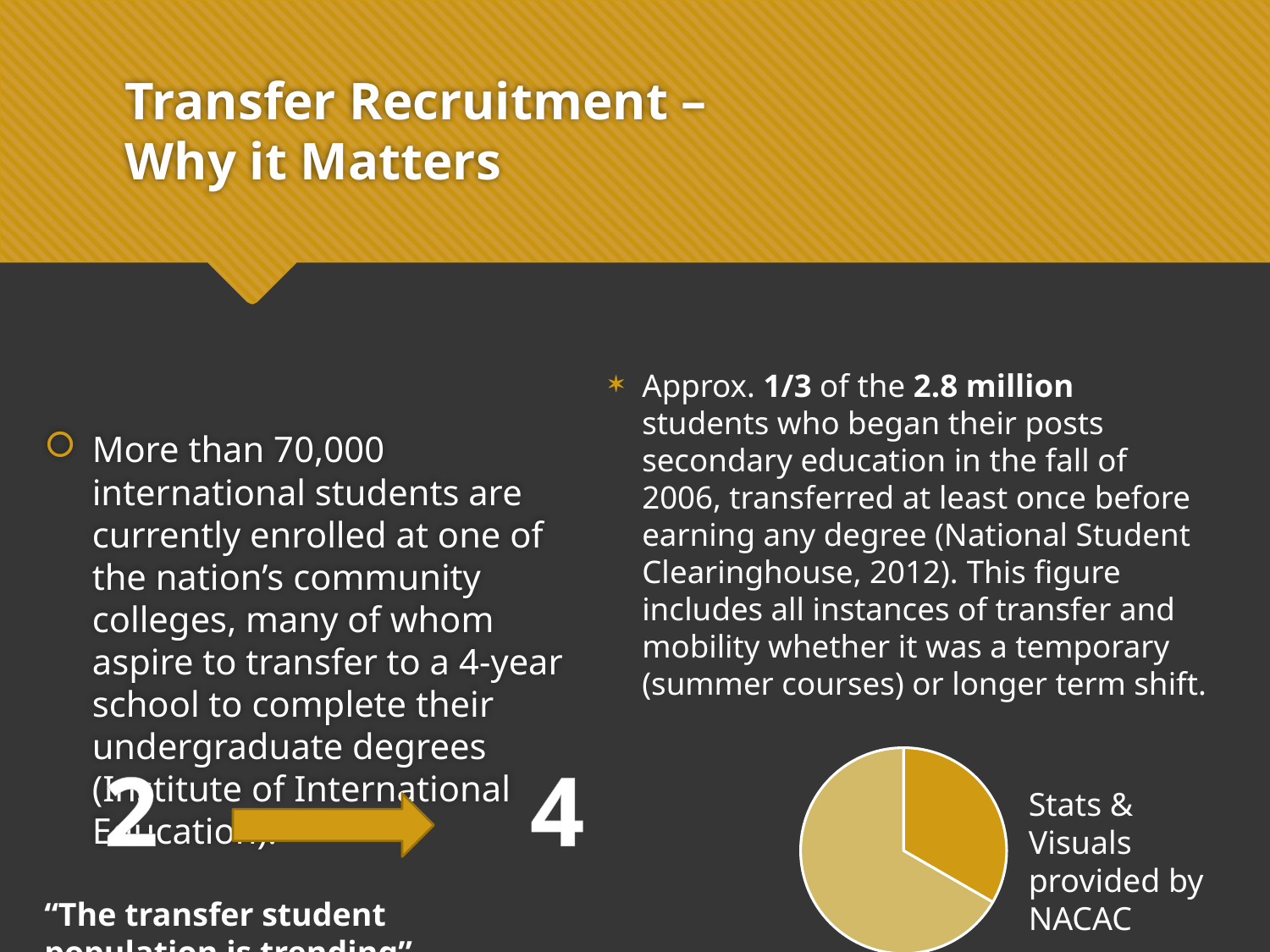
Which slice of the pie chart is larger, the lighter one or the darker gold one? The lighter one How many slices does the pie chart have? 2 What kind of chart is shown at the bottom right of the slide? Pie chart According to the text next to the pie chart, who provided the stats and visuals? NACAC In the pie chart, is the darker gold slice larger or smaller than the lighter slice? Smaller Does the pie chart display any data labels or a legend? No